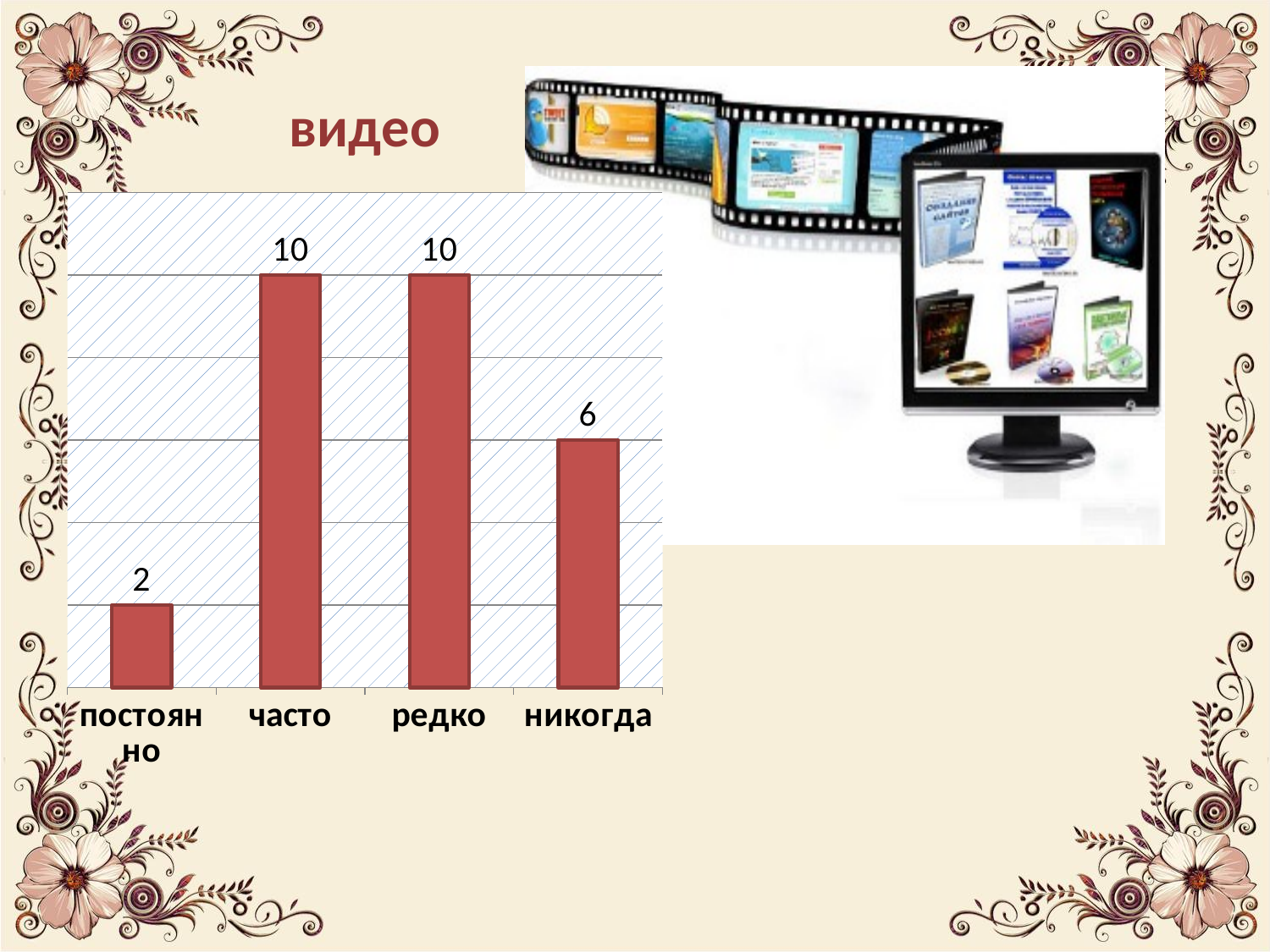
What is the value for "никогда"? 6 What is the difference between the values for "часто" and "никогда"? 4 Which is larger, the value for "редко" or the value for "никогда"? редко What is the title of the chart? видео How many categories are shown on the chart? 4 What is the value for "часто"? 10 Which is larger, the value for "постоянно" or the value for "никогда"? никогда What is the value for "редко"? 10 What is the value for "постоянно"? 2 What kind of chart is shown on the slide? bar chart What is the difference between the values for "никогда" and "постоянно"? 4 Which category has the lowest value? постоянно